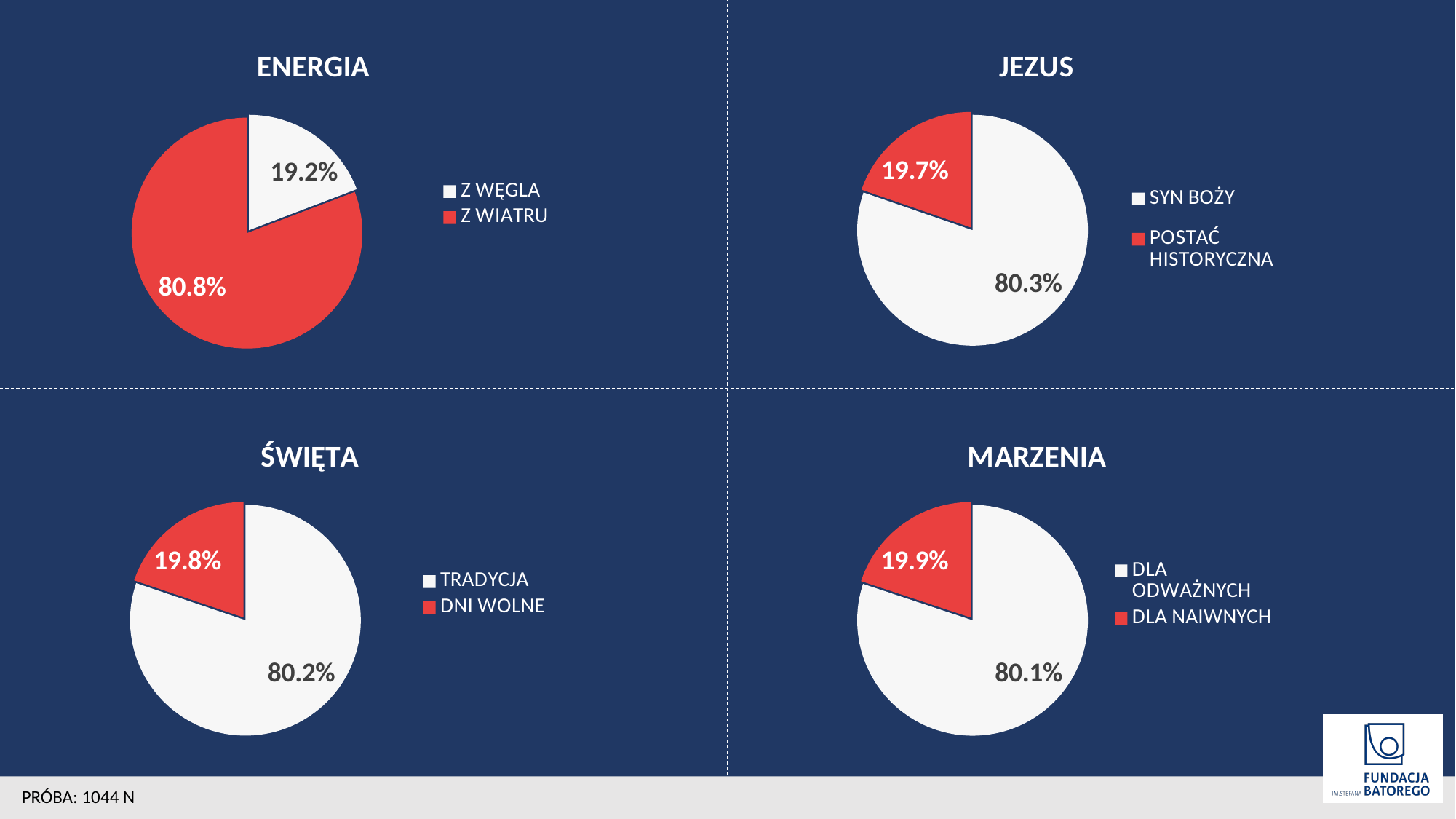
In the MARZENIA chart, which category has the smallest slice? DLA NAIWNYCH In the ŚWIĘTA chart, what share is DNI WOLNE? 19.8% In the MARZENIA chart, what share is DLA ODWAŻNYCH? 80.1% What kind of chart is the MARZENIA chart? Pie chart How many slices does the ŚWIĘTA chart have? 2 In the JEZUS chart, what share is SYN BOŻY? 80.3% In the JEZUS chart, which is larger, SYN BOŻY or POSTAĆ HISTORYCZNA? SYN BOŻY In the ENERGIA chart, what is the difference between Z WIATRU and Z WĘGLA? 61.6% In the ENERGIA chart, what share is Z WĘGLA? 19.2% In the JEZUS chart, what share is POSTAĆ HISTORYCZNA? 19.7% In the ENERGIA chart, what share is Z WIATRU? 80.8% In the ŚWIĘTA chart, which category has the largest slice? TRADYCJA